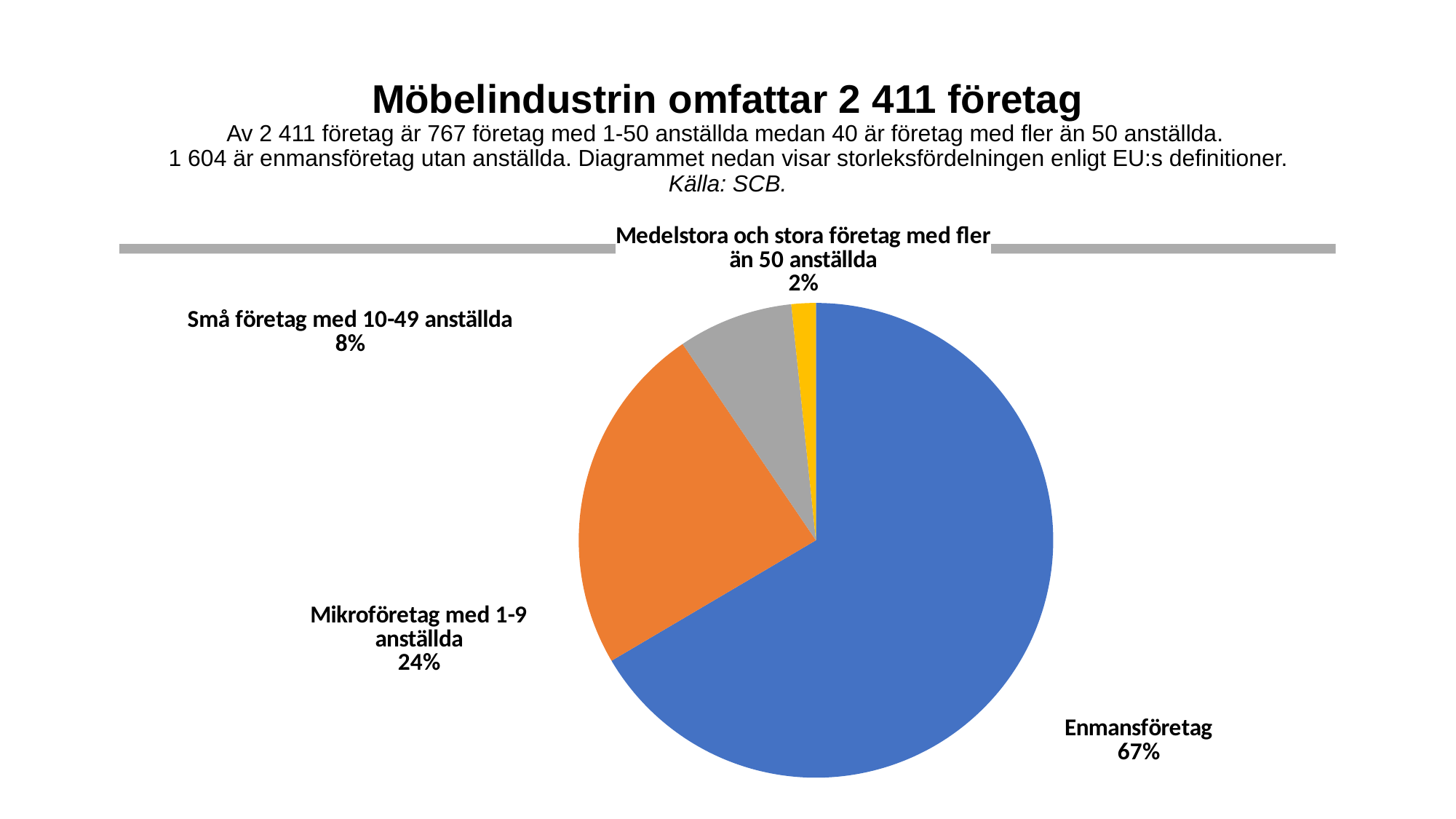
What is the title of the slide? Möbelindustrin omfattar 2 411 företag What colour is the slice for Mikroföretag med 1-9 anställda? Orange What is the difference in percentage points between Enmansföretag and Mikroföretag med 1-9 anställda? 43 percentage points How many categories are shown in the pie chart? 4 Which category has the smallest slice of the pie? Medelstora och stora företag med fler än 50 anställda What share of the pie does Mikroföretag med 1-9 anställda represent? 24% What share of the pie does Enmansföretag represent? 67% What share of the pie does Medelstora och stora företag med fler än 50 anställda represent? 2% What kind of chart is shown on the slide? Pie chart Which category has the largest slice of the pie? Enmansföretag Which is larger, the share for Små företag med 10-49 anställda or the share for Medelstora och stora företag med fler än 50 anställda? Små företag med 10-49 anställda